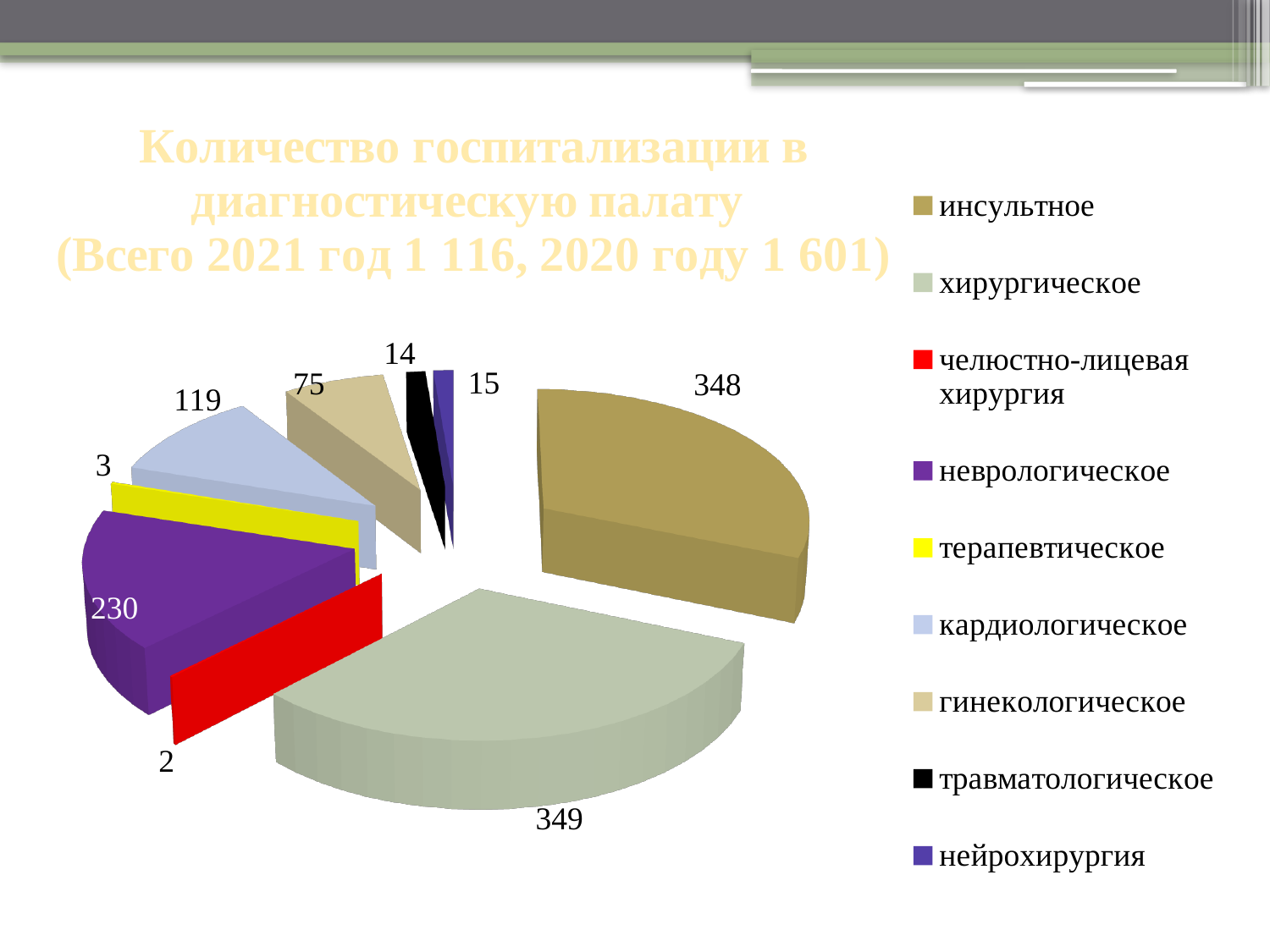
What is the value for кардиологическое in the pie chart? 119 Which category has the smallest value in the pie chart? челюстно-лицевая хирургия What colour represents терапевтическое in the pie chart? yellow What kind of chart is shown on the slide? pie chart Which category has the largest value in the pie chart? хирургическое What is the value for гинекологическое in the pie chart? 75 What is the value for неврологическое in the pie chart? 230 How many categories does the legend of the pie chart list? 9 Which is larger, the value for травматологическое or the value for нейрохирургия? нейрохирургия What is the difference between the values for неврологическое and кардиологическое? 111 What is the value for хирургическое in the pie chart? 349 What is the value for инсультное in the pie chart? 348